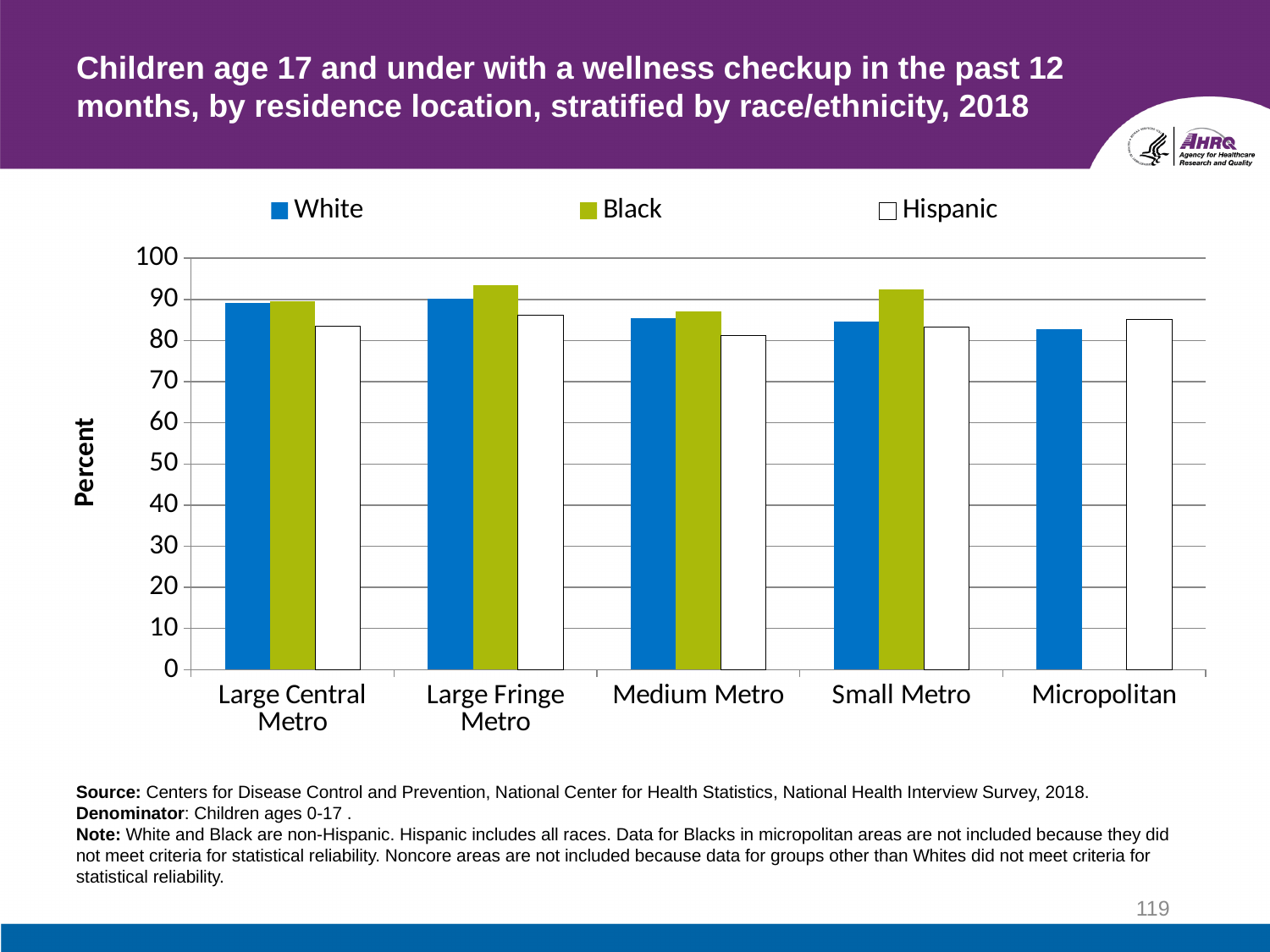
Among the residence locations, where is the Hispanic value lowest? Medium Metro Is the value for Hispanic children in Large Central Metro areas greater or less than 90? less Which residence location is missing a bar for Black children? Micropolitan How many series does the legend list? 3 Is the value for Black children in Large Fringe Metro areas greater or less than 90? greater In Small Metro areas, which group has the larger value, Black or Hispanic? Black What kind of chart is shown on the slide? bar chart What is the label on the y axis? Percent Is the value for White children in Micropolitan areas greater or less than 80? greater How many residence location categories are shown on the x axis? 5 In Large Fringe Metro areas, which group has the larger value, White or Black? Black